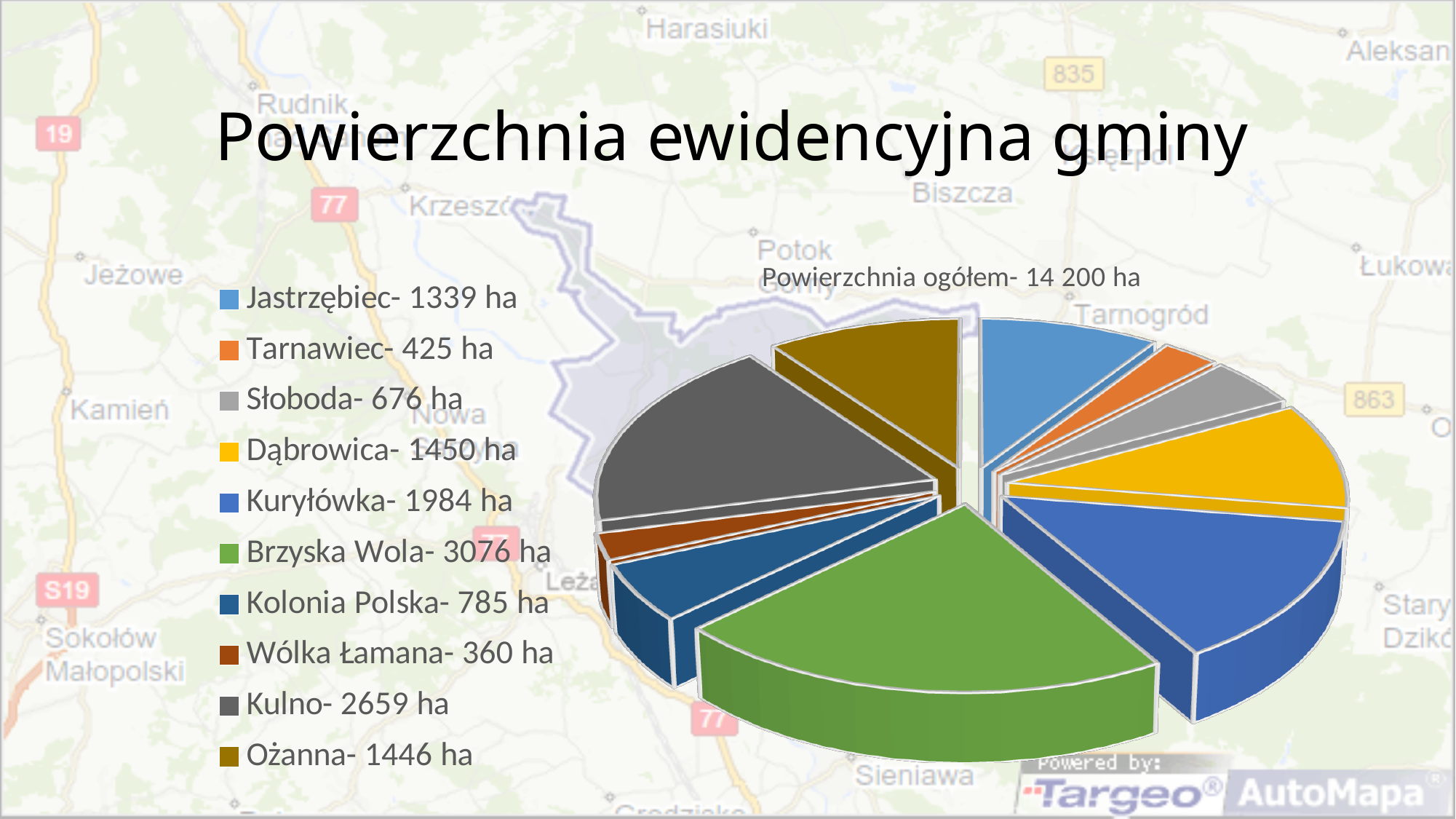
What is the area of Tarnawiec according to the legend? 425 ha What total area is stated in the chart title? 14 200 ha What is the area of Brzyska Wola according to the legend? 3076 ha What is the difference in area between Brzyska Wola and Kulno? 417 ha Which locality has the largest area in the pie chart? Brzyska Wola Which locality has the smallest area in the pie chart? Wólka Łamana Which locality is represented by the green slice? Brzyska Wola How many localities (slices) does the pie chart show? 10 What is the difference in area between Kuryłówka and Jastrzębiec? 645 ha What kind of chart is shown on the slide? pie chart Which has a larger area, Kulno or Kuryłówka? Kulno What is the area of Kulno according to the legend? 2659 ha